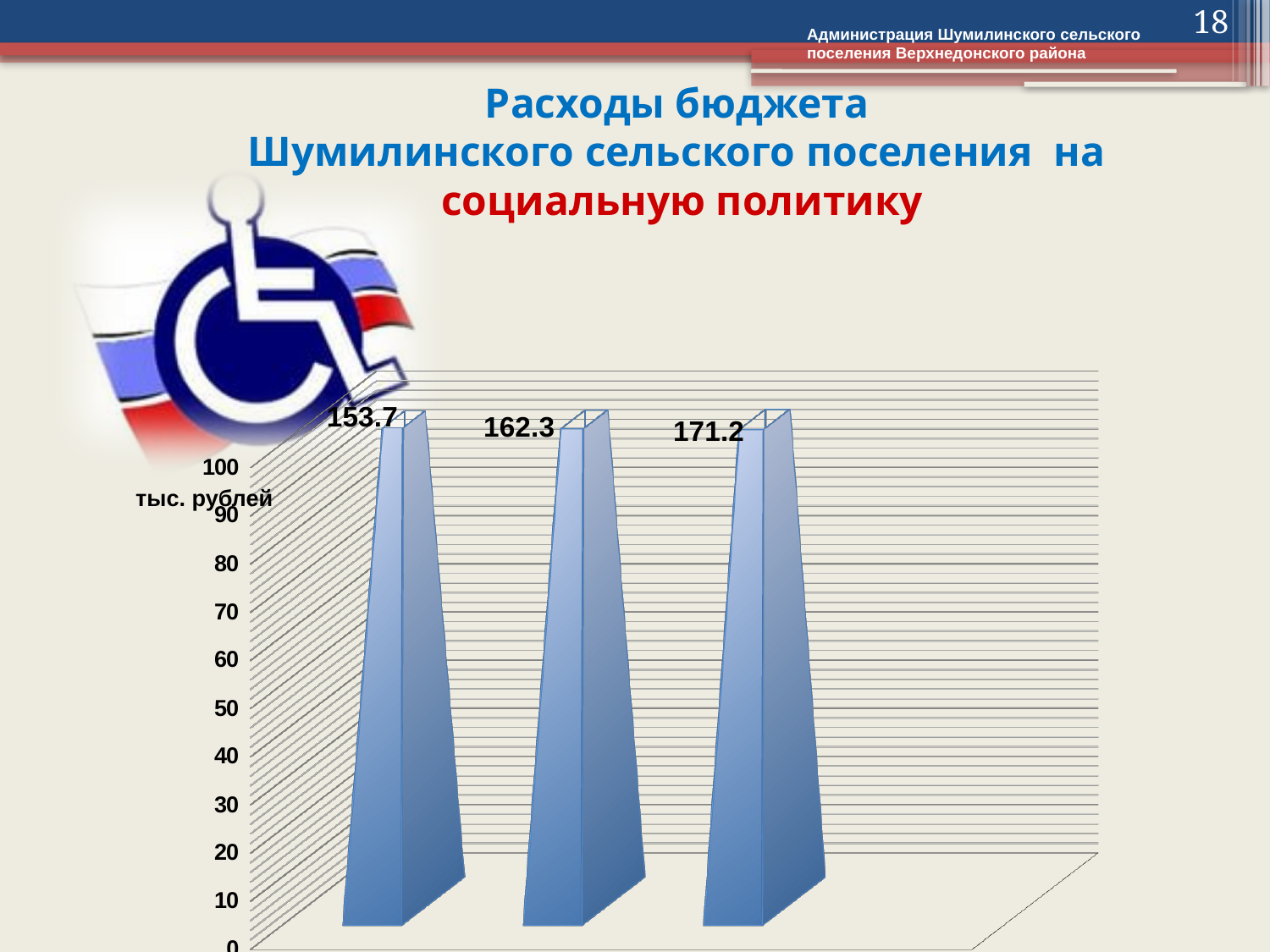
What is the value shown on the leftmost bar? 153.7 Which bar has the lowest value: the left, middle or right one? left What is the value shown on the rightmost bar? 171.2 Which is larger, the value of the middle bar or the value of the rightmost bar? the rightmost bar Which bar has the highest value: the left, middle or right one? right Do the bar values rise or fall from left to right? rise How many bars are plotted in the chart? 3 What is the difference between the middle bar's value and the leftmost bar's value? 8.6 What is the value shown on the middle bar? 162.3 What unit is written next to the vertical axis of the chart? тыс. рублей What kind of chart is shown on the slide? bar chart What is the difference between the rightmost bar's value and the leftmost bar's value? 17.5